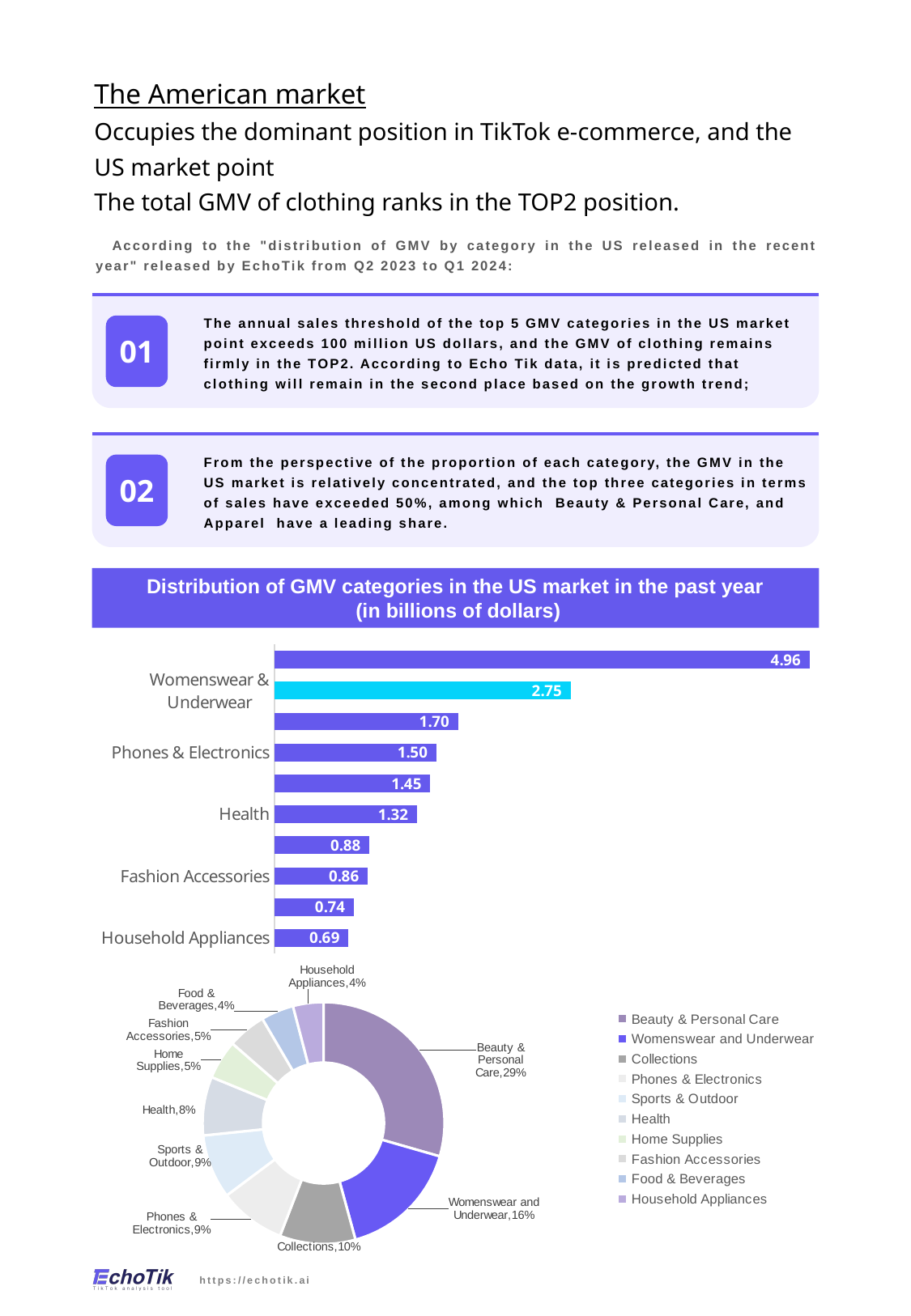
How many entries does the legend of the pie chart at the bottom of the slide list? 10 In the bar chart 'Distribution of GMV categories in the US market in the past year', which labelled category has the lowest value? Household Appliances In the bar chart 'Distribution of GMV categories in the US market in the past year', what is the highest value shown on any bar? 4.96 How many bars are plotted in the bar chart 'Distribution of GMV categories in the US market in the past year'? 10 In the pie chart at the bottom of the slide, what share does Collections have? 10% In the bar chart 'Distribution of GMV categories in the US market in the past year', which is larger: Phones & Electronics or Health? Phones & Electronics In the pie chart at the bottom of the slide, what share does Beauty & Personal Care have? 29% In the bar chart 'Distribution of GMV categories in the US market in the past year', what is the value for Womenswear & Underwear? 2.75 In the bar chart 'Distribution of GMV categories in the US market in the past year', what is the value for Phones & Electronics? 1.50 In the bar chart 'Distribution of GMV categories in the US market in the past year', what is the value for Household Appliances? 0.69 In the bar chart 'Distribution of GMV categories in the US market in the past year', what is the difference between the values for Health and Fashion Accessories? 0.46 What kind of chart is the chart at the bottom of the slide showing category percentages? Pie chart (donut)